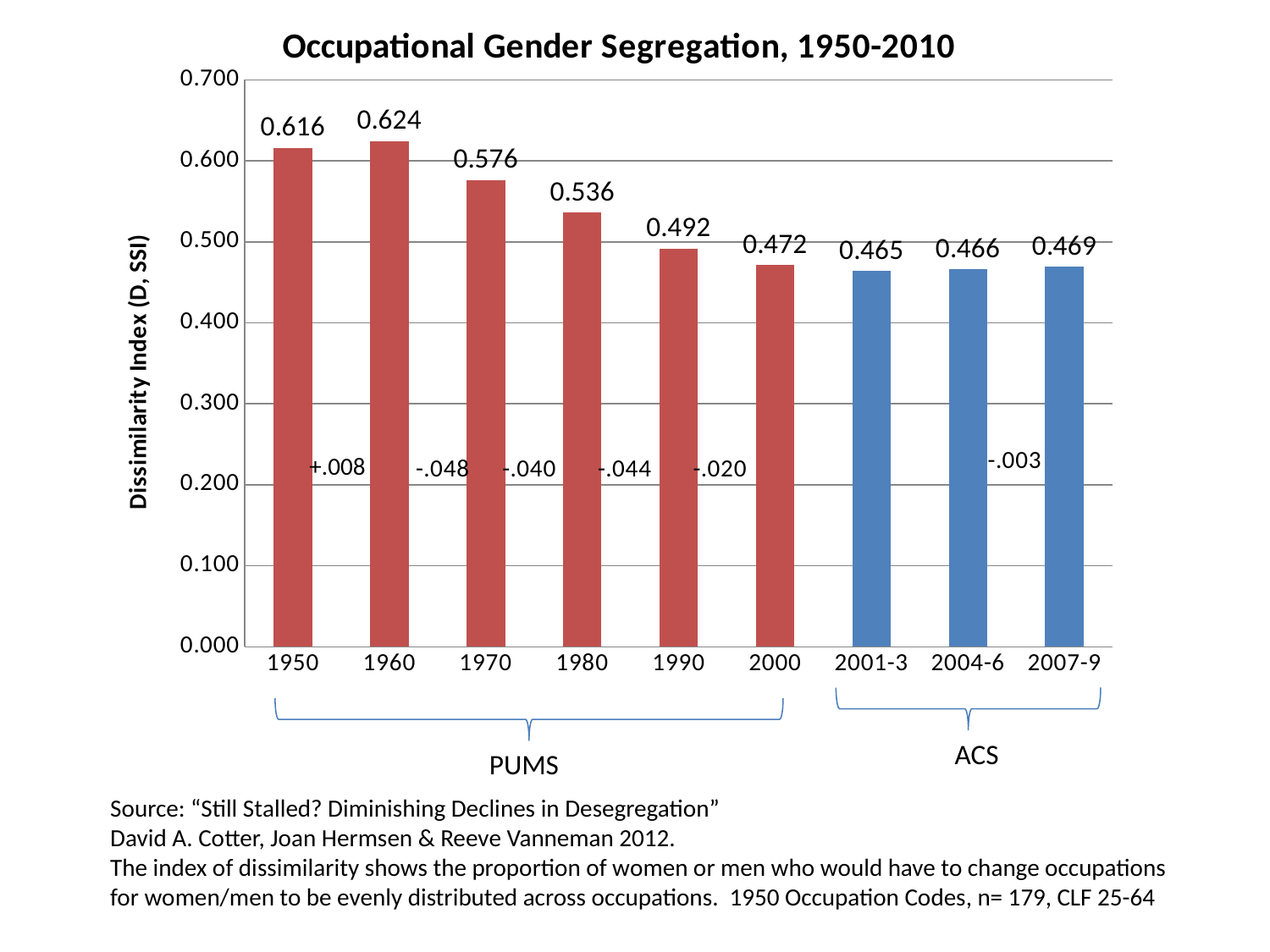
Which year has the highest dissimilarity index value? 1960 What is the difference between the dissimilarity index values for 1950 and 2000? 0.144 What is the label on the vertical axis of the chart? Dissimilarity Index (D, SSI) Do the dissimilarity index values rise or fall from 1960 to 2000? Fall What is the dissimilarity index value for 2007-9? 0.469 What is the difference between the dissimilarity index values for 1960 and 1950? 0.008 Is the value for 2000 greater or less than 0.500? less Which has a larger dissimilarity index value, 1970 or 1990? 1970 How many bars are shown in the chart? 9 What is the dissimilarity index value for 1950? 0.616 What is the dissimilarity index value for 1980? 0.536 What kind of chart is shown on the slide? Bar chart